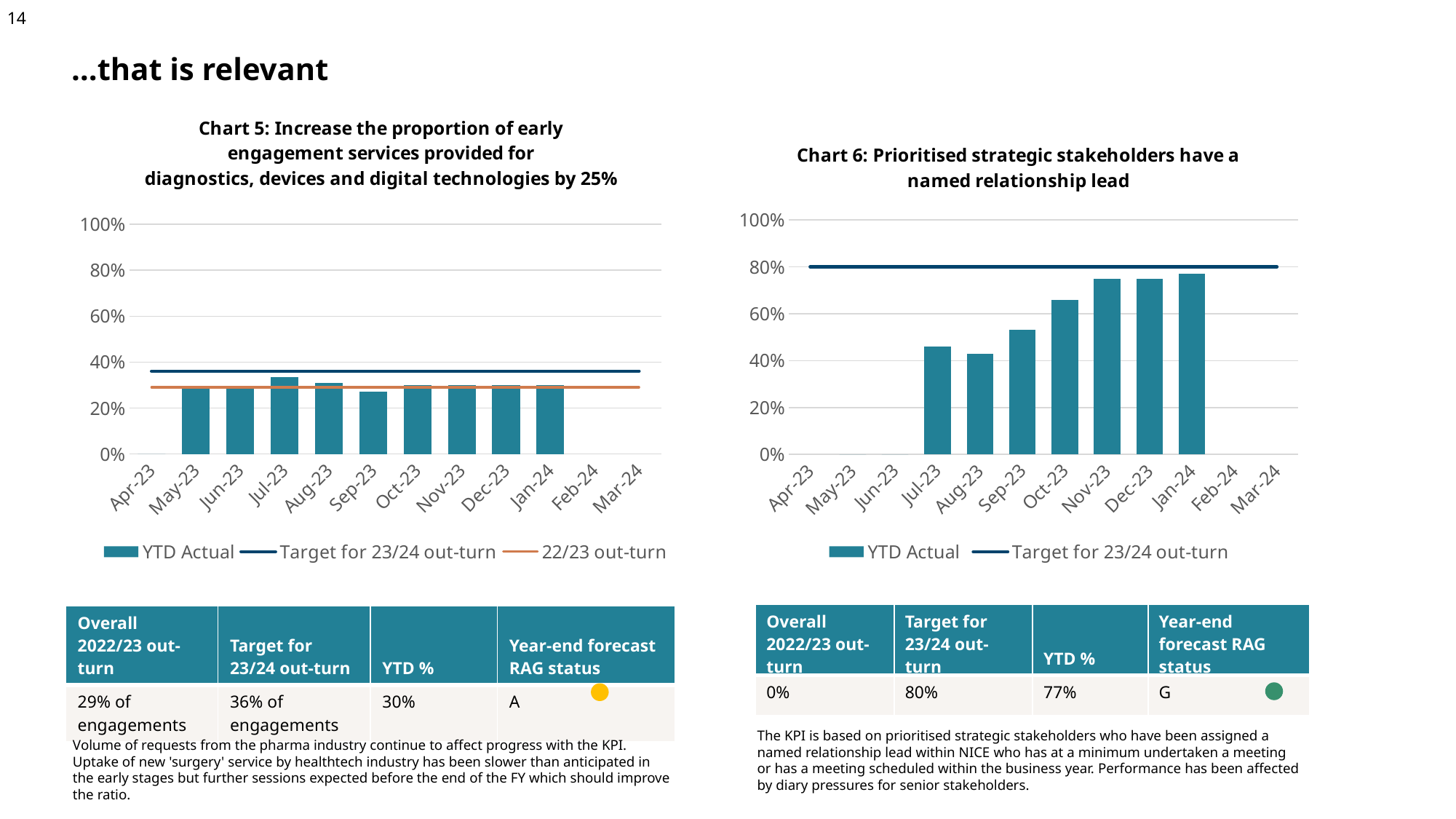
In Chart 6, is the YTD Actual value for Oct-23 greater or less than 60%? greater In Chart 5, how many months are labelled on the x axis? 12 In Chart 5, is the YTD Actual value for Jul-23 greater or less than 40%? less In Chart 5, how many series does the legend list? 3 In Chart 6, how many series does the legend list? 2 In Chart 6, which month with a bar has the lowest YTD Actual value? Aug-23 In Chart 6, which is larger, the YTD Actual for Nov-23 or for Sep-23? Nov-23 In Chart 5, is the YTD Actual value for Sep-23 greater or less than 20%? greater What kind of chart is Chart 5? bar chart In Chart 6, which month has the highest YTD Actual bar? Jan-24 In Chart 6, do the YTD Actual bars generally rise or fall from Jul-23 to Jan-24? rise In Chart 5, which month has the highest YTD Actual bar? Jul-23